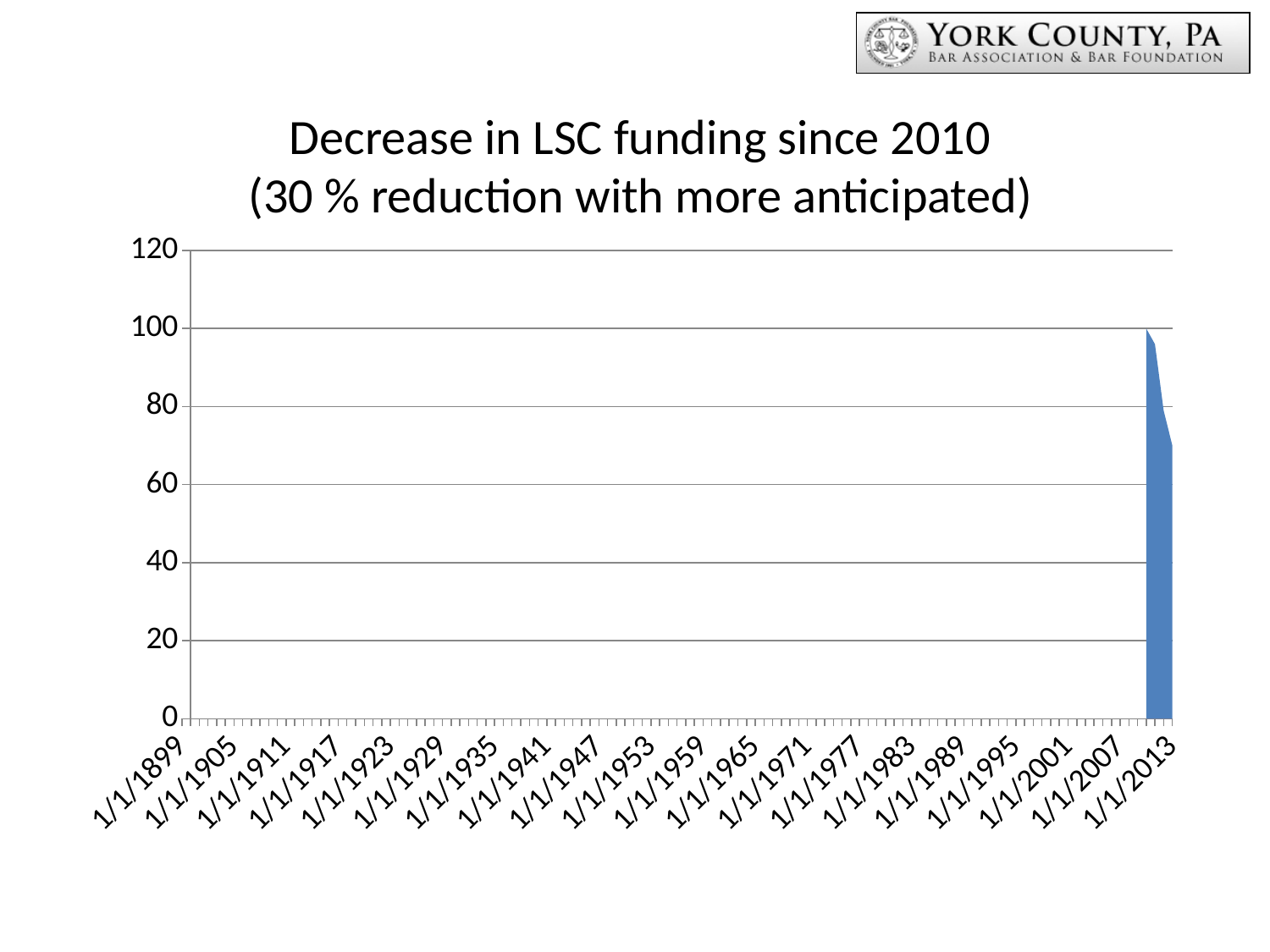
What kind of chart is shown on the slide? area chart Do the plotted values rise or fall as the x axis moves toward 1/1/2013? fall Is the highest plotted value greater or less than 80? greater What colour is the plotted area in the chart? blue Is the value at 1/1/2013 greater or less than 80? less Is the value at 1/1/2013 greater or less than 60? greater What is the title of the chart? Decrease in LSC funding since 2010 (30 % reduction with more anticipated)